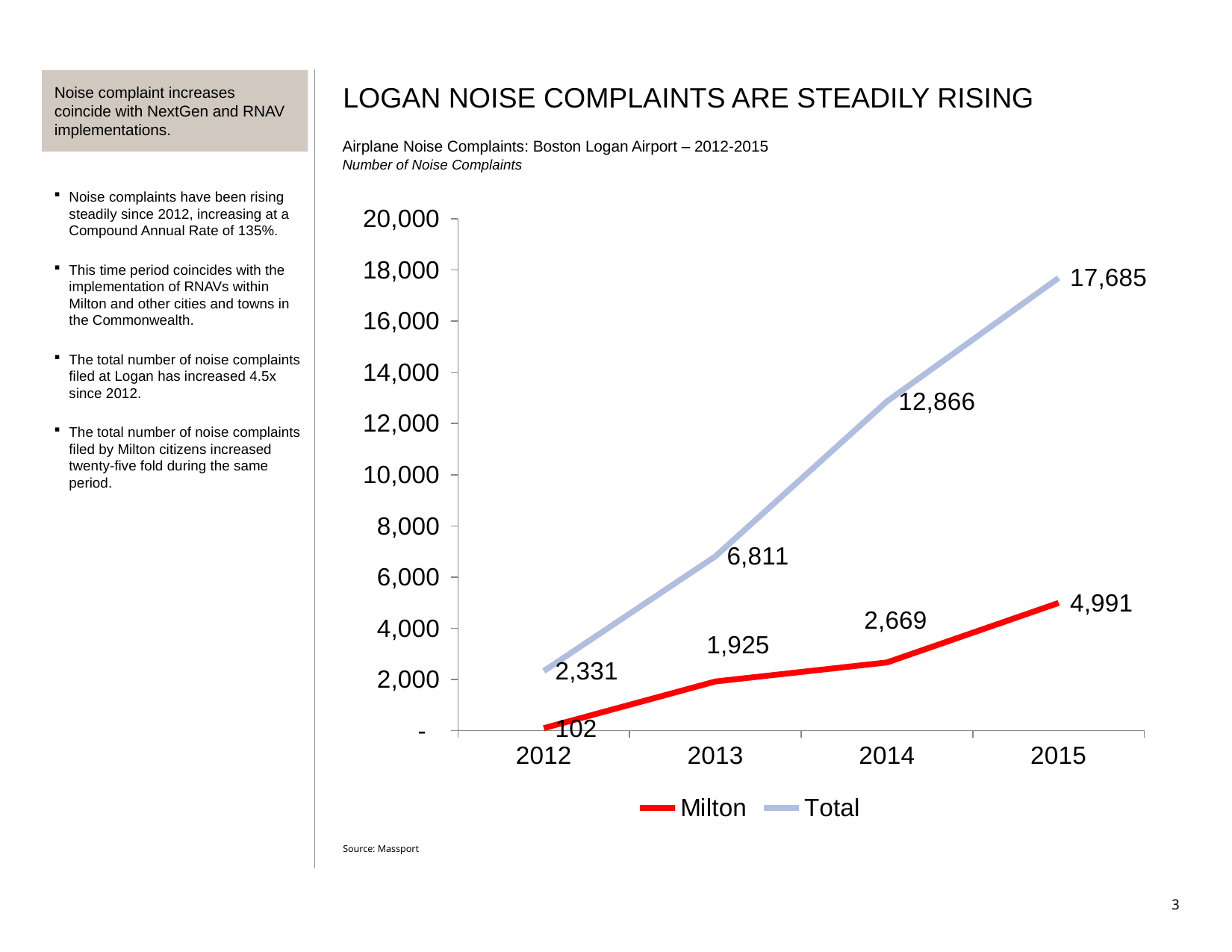
What is the difference between the Total and Milton noise complaints in 2015? 12,694 What kind of chart is shown on the slide? Line chart How many years are shown on the x axis? 4 In which year was the Total number of noise complaints highest? 2015 What was the Total number of noise complaints in 2015? 17,685 What was the number of noise complaints from Milton in 2014? 2,669 By how much did the Total number of noise complaints increase from 2013 to 2014? 6,055 Which was larger in 2014: the Total complaints or the Milton complaints? Total What was the Total number of noise complaints in 2013? 6,811 In which year was the number of Milton noise complaints lowest? 2012 How many series does the legend list? 2 What was the number of noise complaints from Milton in 2012? 102